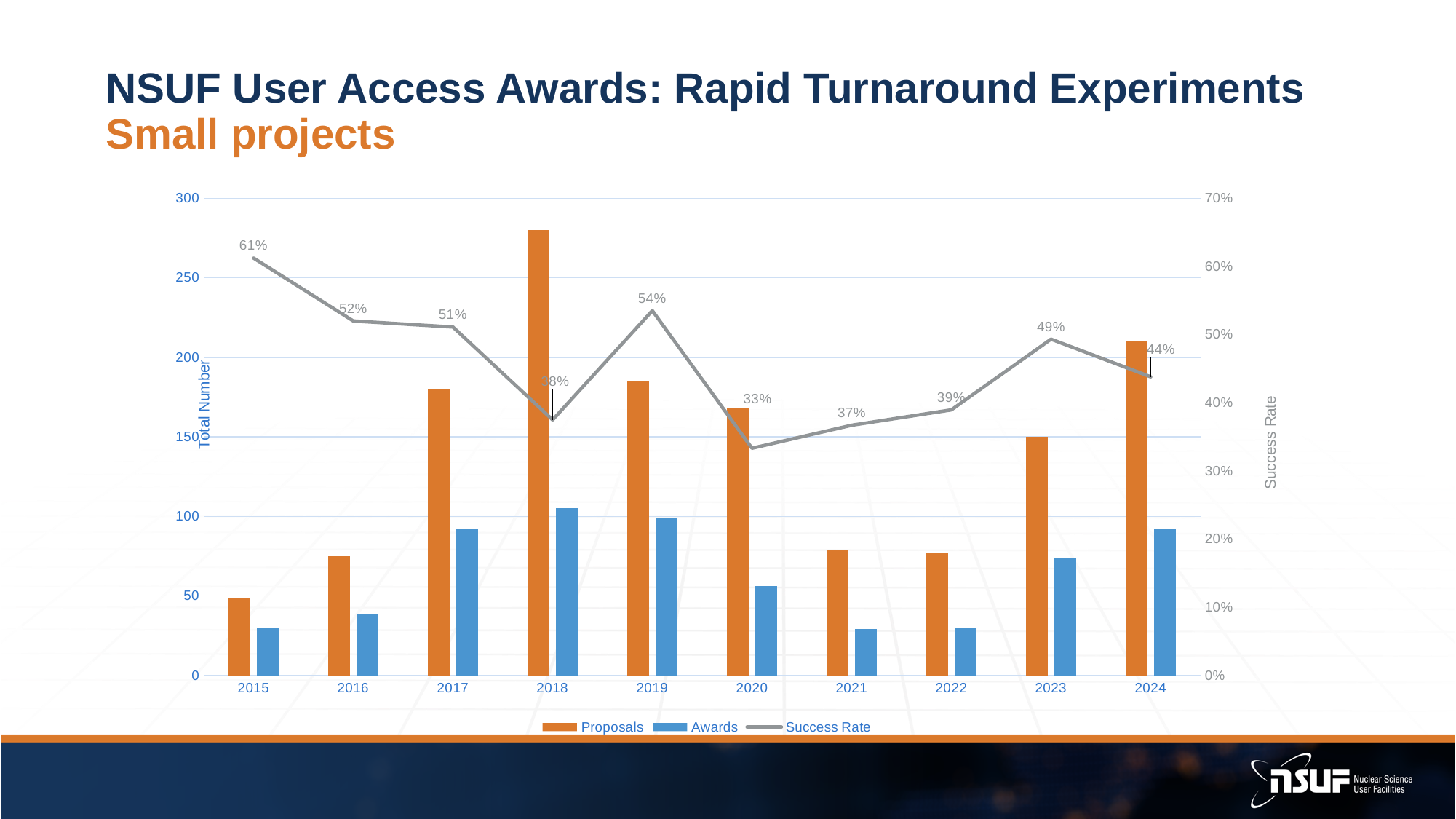
Which year has the higher success rate, 2019 or 2017? 2019 What is the success rate shown for 2019? 54% In which year is the success rate highest? 2015 In which year is the number of Proposals highest? 2018 Is the value for Proposals in 2021 greater or less than 100? less What is the success rate shown for 2015? 61% How many series does the legend list? 3 What is the difference between the success rate in 2015 and the success rate in 2020? 28 percentage points What is the success rate shown for 2023? 49% Is the value for Proposals in 2018 greater or less than 250? greater In which year is the success rate lowest? 2020 How many years are shown on the x axis? 10